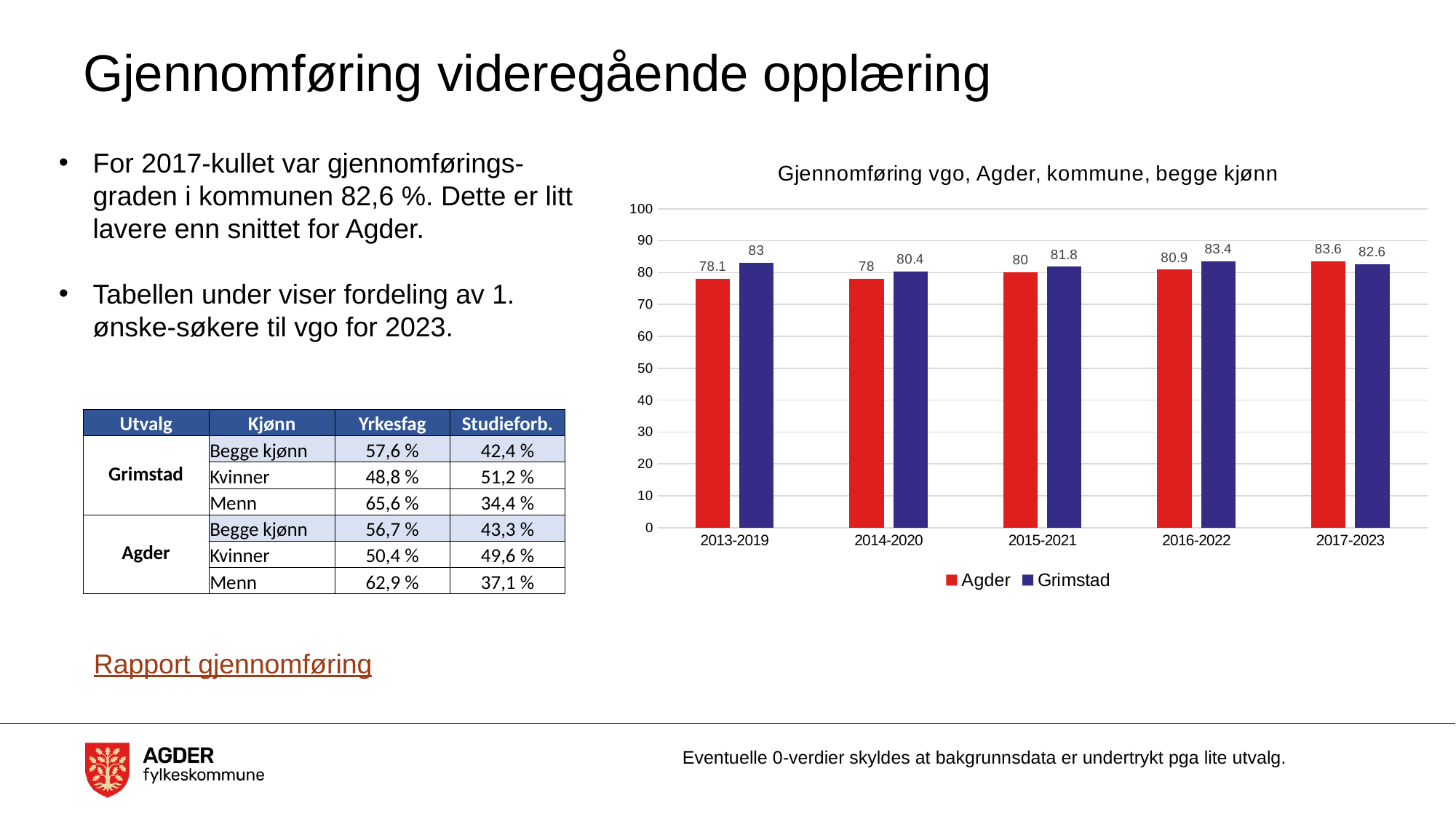
How many periods are shown on the x axis? 5 Is the value for Agder in 2014-2020 greater or less than 90? less What is the difference between Grimstad and Agder in 2016-2022? 2.5 Which period has the highest value for Agder? 2017-2023 What is the value for Grimstad in 2017-2023? 82.6 Which is larger in 2017-2023, Agder or Grimstad? Agder Do the values for Agder rise or fall from 2014-2020 to 2017-2023? rise How many series does the legend list? 2 What kind of chart is shown? bar chart Which period has the lowest value for Grimstad? 2014-2020 What is the value for Grimstad in 2015-2021? 81.8 What is the value for Agder in 2013-2019? 78.1